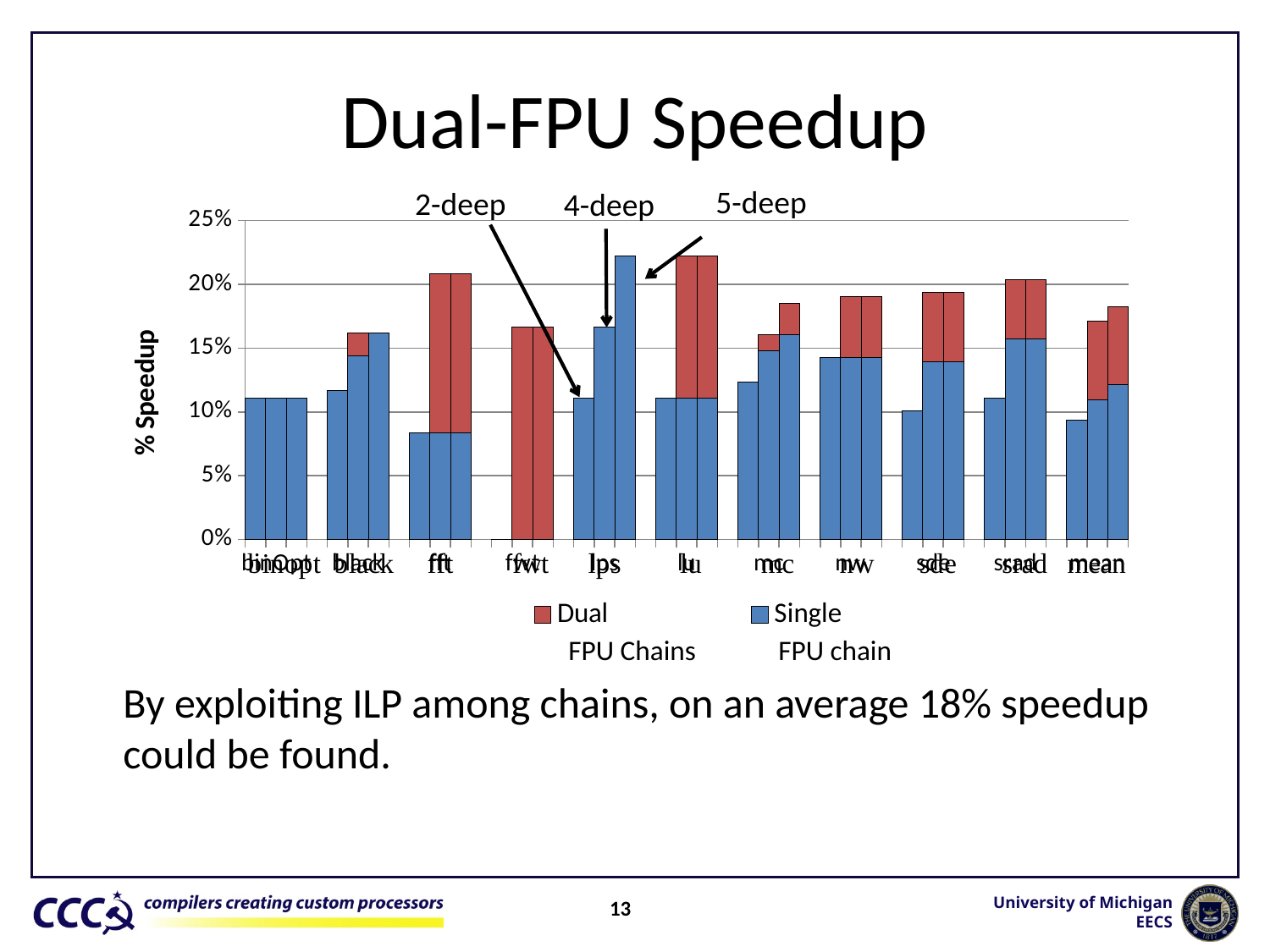
Is the tallest bar for mean greater or less than 15%? greater What is the title of the chart? Dual-FPU Speedup What is the label on the y axis of the chart? % Speedup Is the tallest bar for fft greater or less than 15%? greater Are the bars for binOpt greater or less than 15%? less Which category has taller bars, binOpt or nw? nw What kind of chart is shown on the slide? Stacked bar chart Which category has taller bars, fwt or lu? lu How many benchmark categories are shown along the x axis of the chart? 11 How many series does the chart legend list? 2